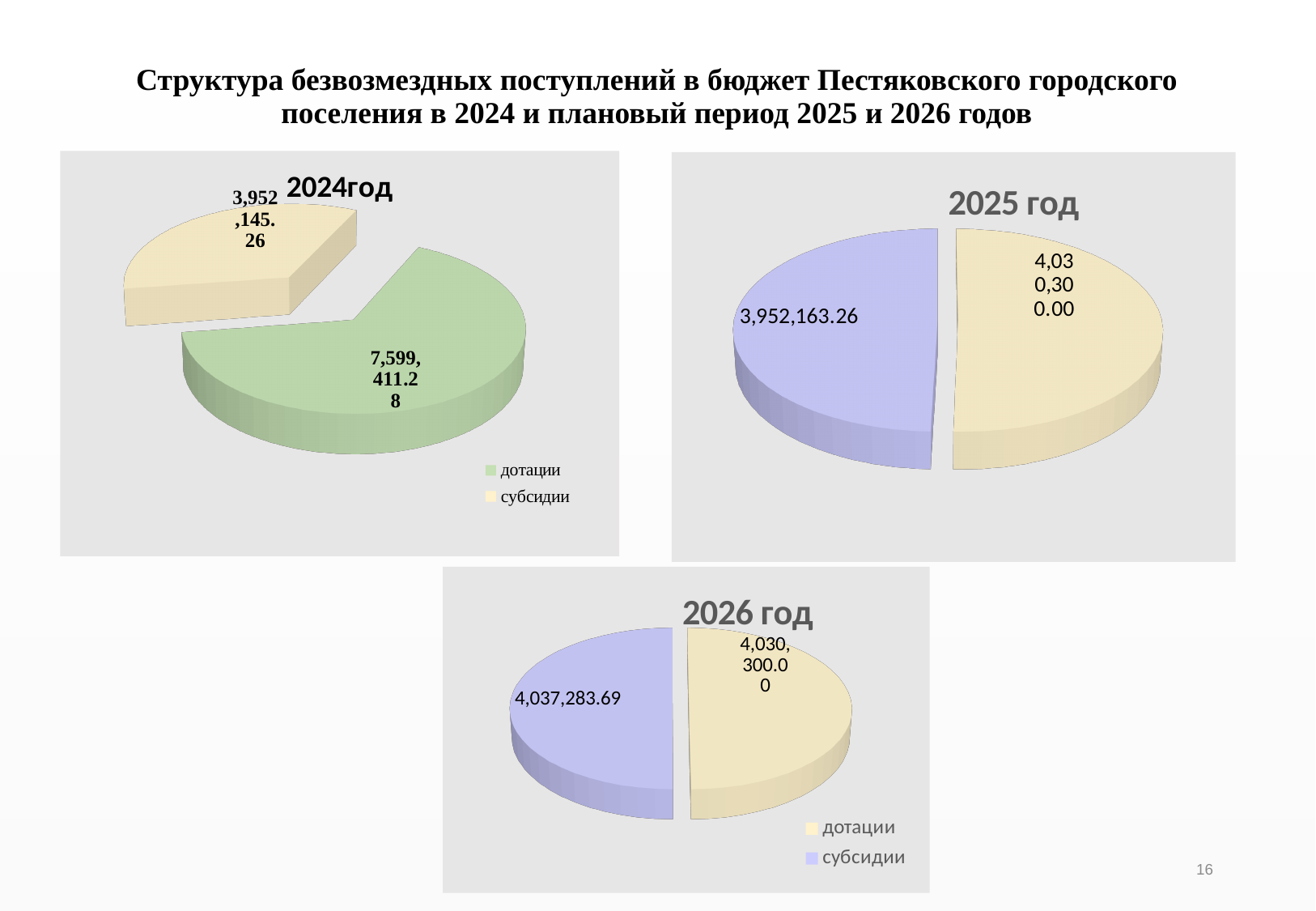
In the 2025 год chart, what is the total of the two slices? 7,982,463.26 In the 2026 год chart, what is the value for дотации? 4,030,300.00 How many pie charts are on the slide? 3 In the 2024 год chart, what is the value for дотации? 7,599,411.28 In the 2025 год chart, what is the value shown on the purple slice? 3,952,163.26 In the 2024 год chart, what is the total of the two slices? 11,551,556.54 What kind of chart is the 2026 год chart? pie chart In the 2024 год chart, what is the difference between дотации and субсидии? 3,647,266.02 In the 2024 год chart, what is the value for субсидии? 3,952,145.26 In the 2025 год chart, what is the value shown on the beige slice? 4,030,300.00 In the 2024 год chart, which category has the larger value? дотации In the 2026 год chart, what is the value for субсидии? 4,037,283.69